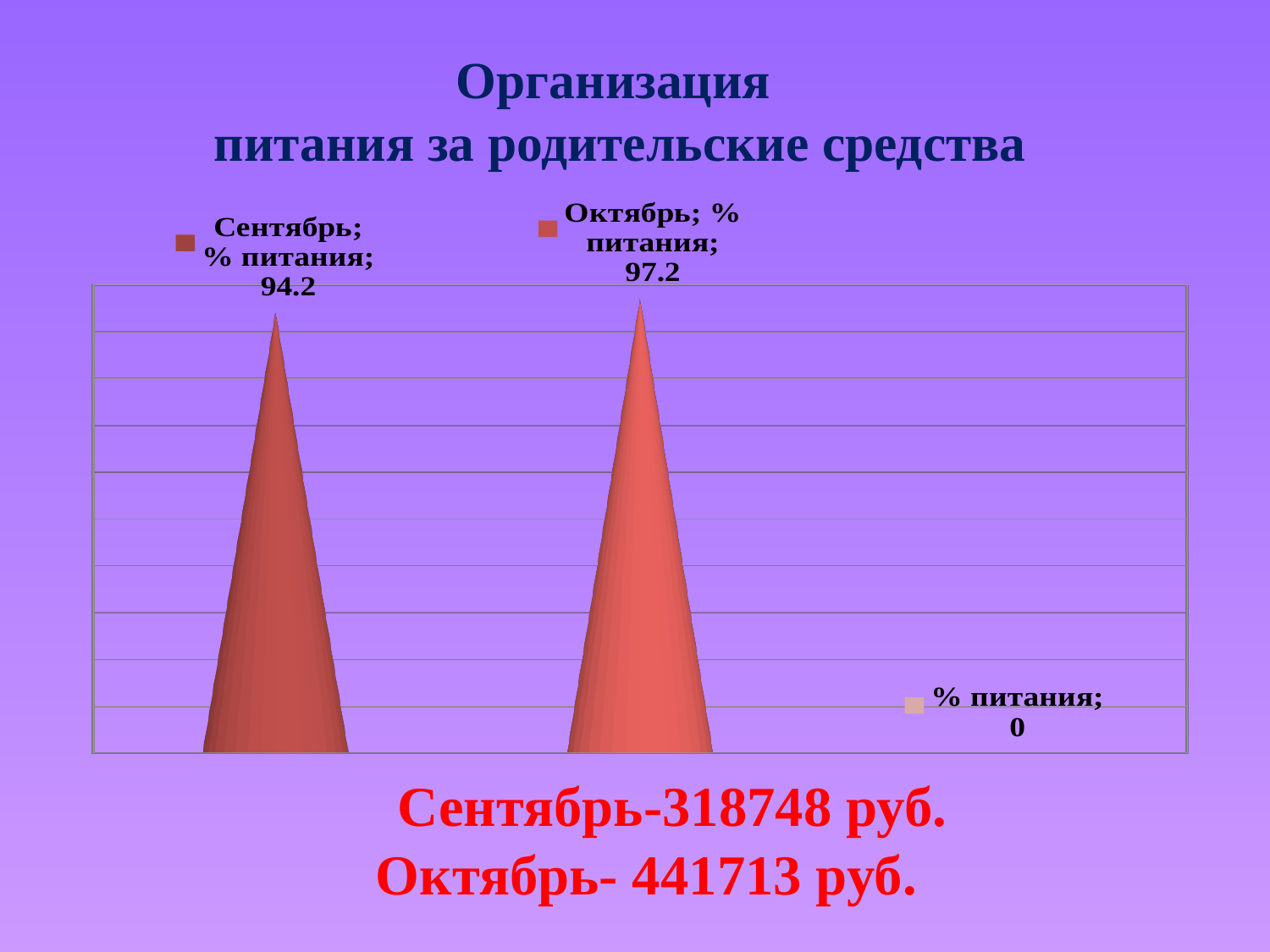
Does the % питания value rise or fall from Сентябрь to Октябрь? Rise How many bars are drawn on the chart? 2 Which month has the higher % питания value, Сентябрь or Октябрь? Октябрь Which month has the highest % питания value on the chart? Октябрь What is the difference between the % питания values for Октябрь and Сентябрь? 3.0 What is the % питания value for Октябрь? 97.2 What kind of chart is shown on the slide? Bar chart What value is shown for the third data label on the right of the chart? 0 What is the % питания value for Сентябрь? 94.2 Which of the two months shown with bars has the lower % питания value? Сентябрь What amount in rubles is given for Октябрь in the text below the chart? 441713 руб. What is the title of the slide containing the chart? Организация питания за родительские средства